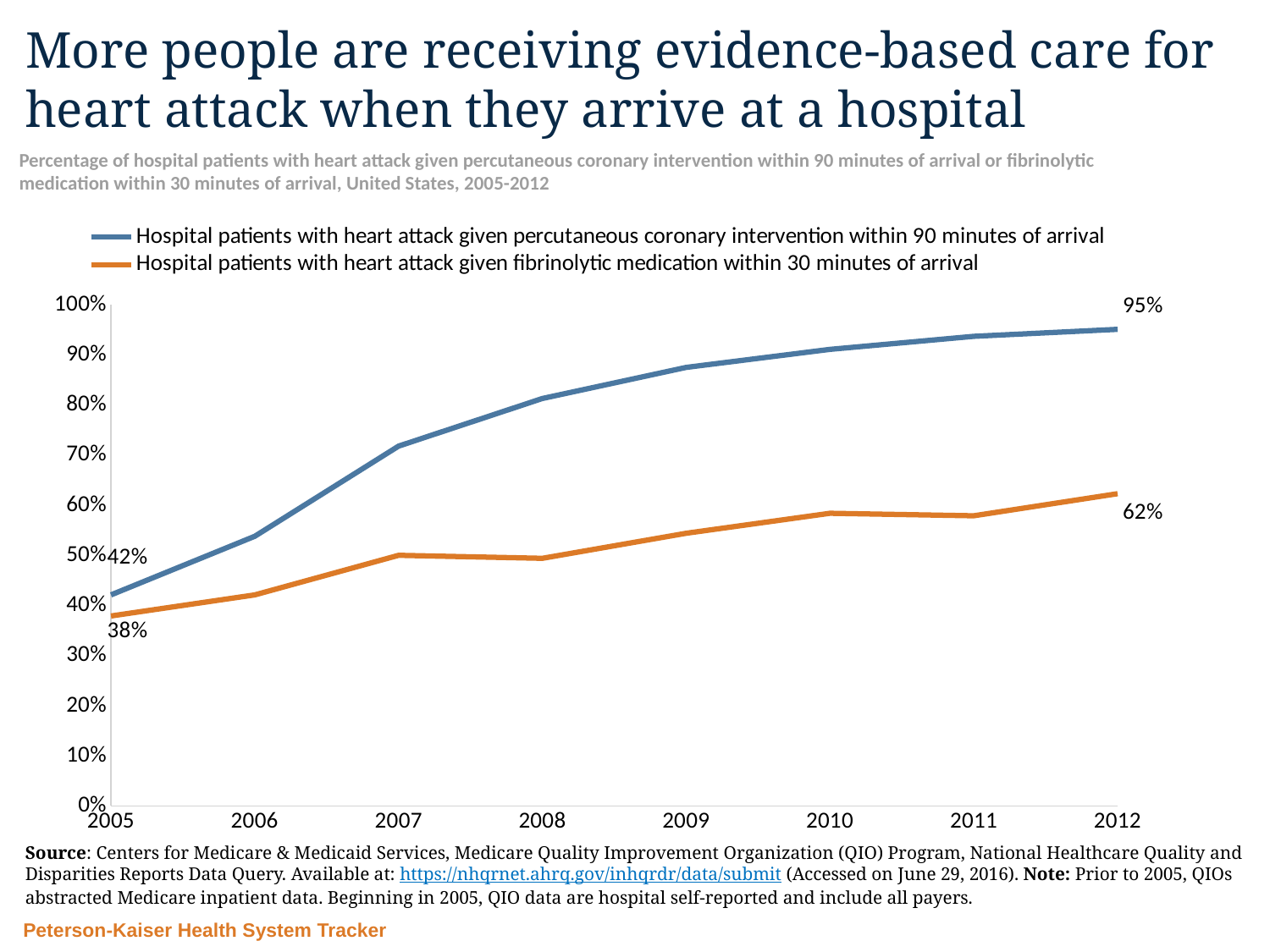
Is the value for percutaneous coronary intervention within 90 minutes of arrival in 2008 greater or less than 70%? greater What was the percentage of hospital patients with heart attack given percutaneous coronary intervention within 90 minutes of arrival in 2005? 42% Which series had the higher value in 2012: percutaneous coronary intervention within 90 minutes or fibrinolytic medication within 30 minutes? Percutaneous coronary intervention within 90 minutes of arrival What was the percentage of hospital patients with heart attack given fibrinolytic medication within 30 minutes of arrival in 2012? 62% How many years are shown on the x axis? 8 By how many percentage points did the share of patients given percutaneous coronary intervention within 90 minutes of arrival increase from 2005 to 2012? 53 percentage points What was the percentage of hospital patients with heart attack given percutaneous coronary intervention within 90 minutes of arrival in 2012? 95% How many series does the legend list? 2 Does the percentage of patients given percutaneous coronary intervention within 90 minutes of arrival rise or fall from 2005 to 2012? rise What kind of chart is shown on the slide? line chart In 2012, what is the difference between the percutaneous coronary intervention series and the fibrinolytic medication series? 33 percentage points What was the percentage of hospital patients with heart attack given fibrinolytic medication within 30 minutes of arrival in 2005? 38%